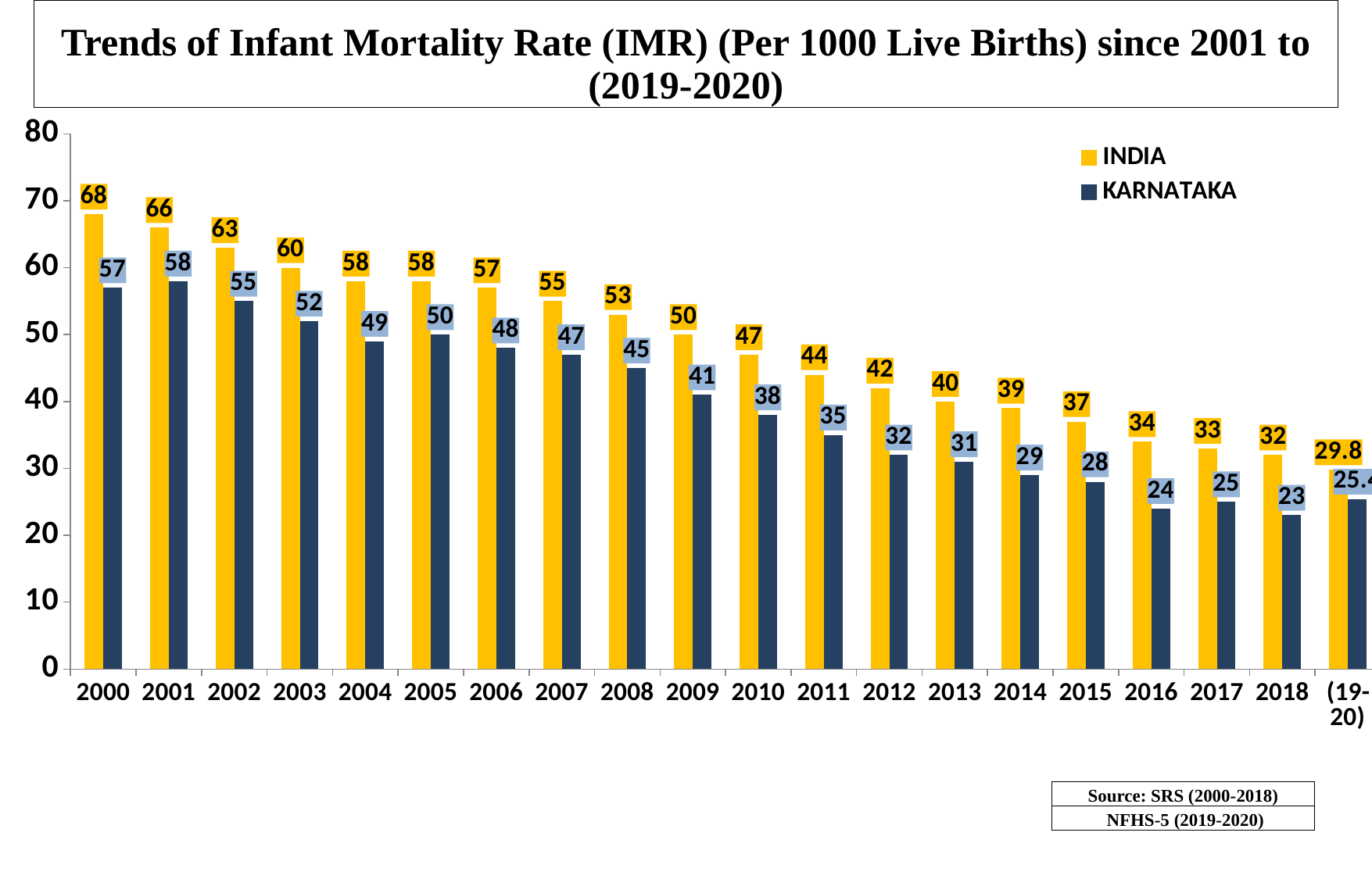
Which is larger, the INDIA value for 2012 or the KARNATAKA value for 2003? KARNATAKA value for 2003 Do the INDIA values rise or fall from 2000 to 2018? Fall Which year has the highest INDIA value? 2000 What is the KARNATAKA value for 2009? 41 How many categories are shown on the x axis? 20 Which colour represents KARNATAKA in the chart? Dark blue What kind of chart is shown on the slide? Bar chart Which year has the lowest KARNATAKA value? 2018 What is the difference between the INDIA and KARNATAKA values for 2005? 8 What is the INDIA value for (19-20)? 29.8 How many series does the legend list? 2 What is the INDIA value for 2000? 68